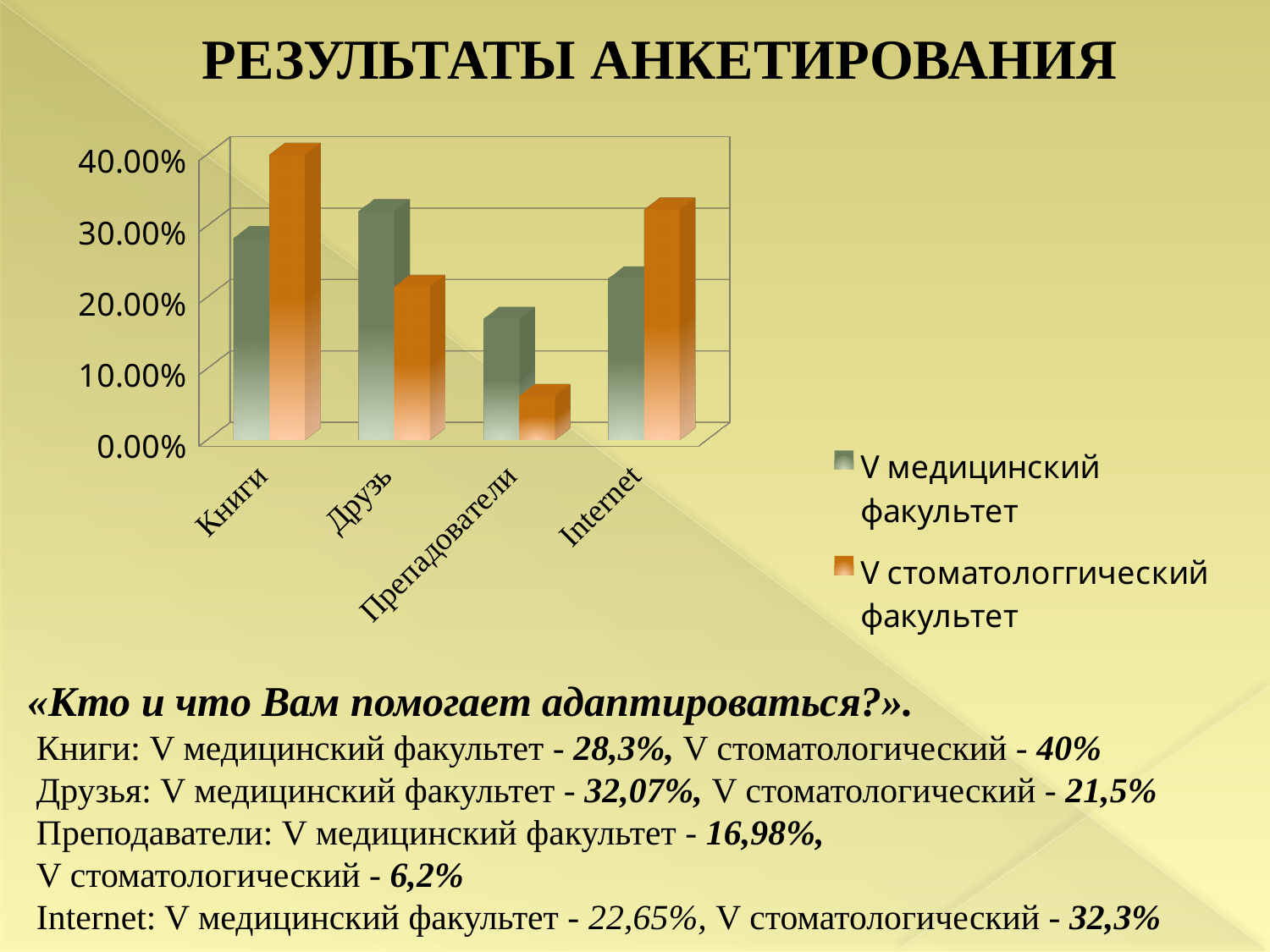
How many categories are shown on the x axis of the chart? 4 Is the value for Internet for the V стоматологический факультет series greater or less than 30.00%? greater What is the value for Internet for the V медицинский факультет series? 22,65% What is the value for Преподаватели for the V стоматологический факультет series? 6,2% Which category has the lowest value for the V медицинский факультет series? Преподаватели What is the value for Друзья for the V медицинский факультет series? 32,07% What kind of chart is shown on the slide? bar chart What is the difference between the V стоматологический факультет and V медицинский факультет values for Книги? 11,7% Which category has the highest value for the V стоматологический факультет series? Книги How many series does the chart legend list? 2 For Друзья, which series has the larger value: V медицинский факультет or V стоматологический факультет? V медицинский факультет What is the value for Книги for the V стоматологический факультет series? 40%